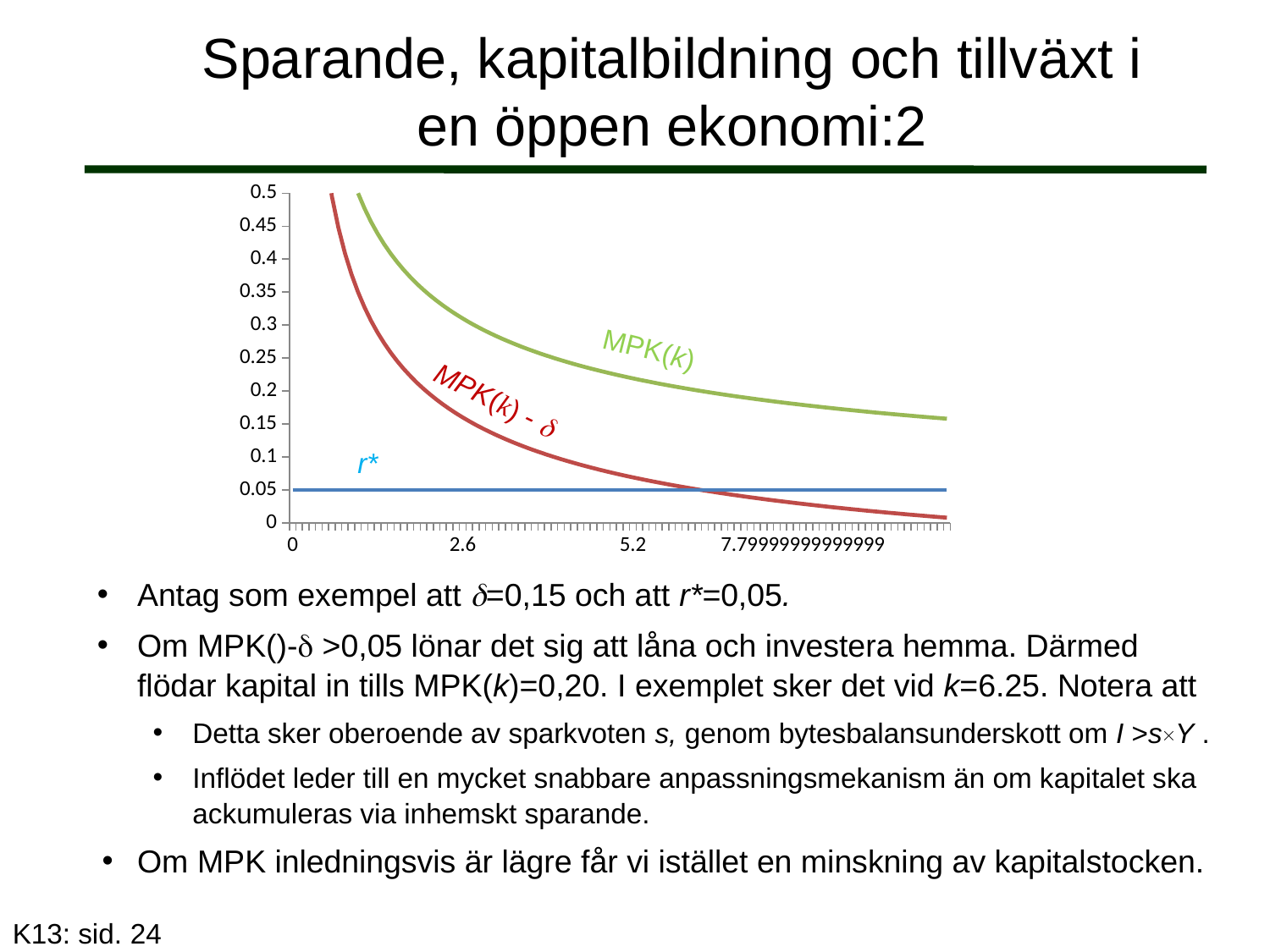
What is the value of the horizontal r* line? 0.05 Does the MPK(k) curve rise or fall as k increases? fall At k = 5.2, is the value of MPK(k) - δ greater or less than 0.1? less Does the MPK(k) - δ curve rise or fall as k increases? fall What colour is the MPK(k) curve? green What is the highest value shown on the y axis? 0.5 What kind of chart is shown on the slide? line chart At k = 7.8, is the value of MPK(k) - δ greater or less than 0.05? less Which curve lies higher, MPK(k) or MPK(k) - δ? MPK(k) How many curves/lines are plotted in the chart? 3